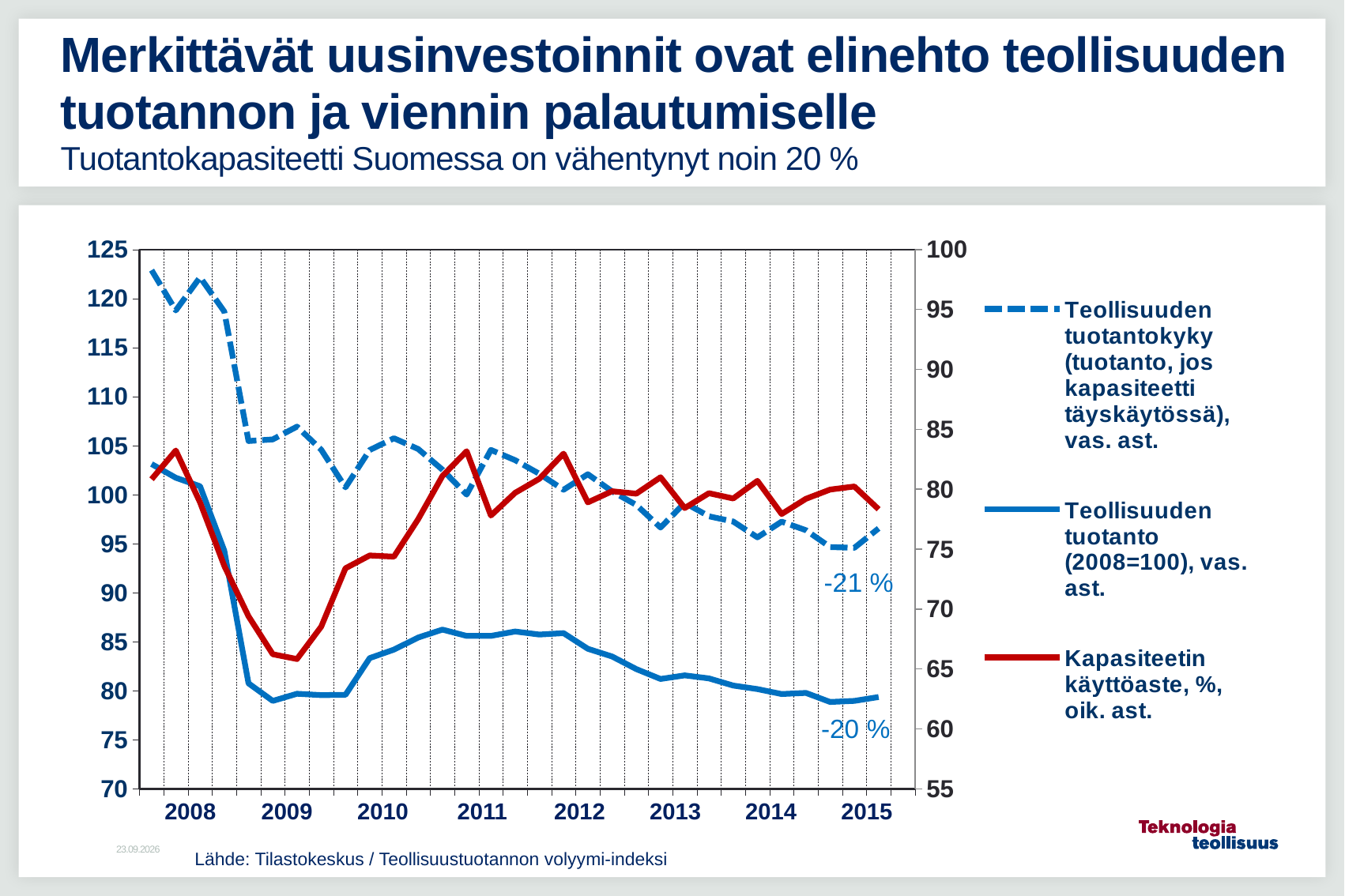
Is the value for Teollisuuden tuotanto in 2015 greater or less than 85 on the left axis? less Is the lowest value of Kapasiteetin käyttöaste in 2009 greater or less than 70 on the right axis? less What percentage change is annotated on the chart for Teollisuuden tuotantokyky? -21 % How many series does the legend list? 3 Is the value for Teollisuuden tuotantokyky at the start of 2008 greater or less than 120 on the left axis? greater What kind of chart is shown on the slide? line chart Does Teollisuuden tuotanto rise or fall overall from 2008 to 2015? fall Which series is drawn with a dashed line? Teollisuuden tuotantokyky Does Teollisuuden tuotantokyky rise or fall overall from 2008 to 2015? fall What percentage change is annotated on the chart for Teollisuuden tuotanto? -20 % Which series is plotted against the right-hand axis (oik. ast.)? Kapasiteetin käyttöaste, % In 2015, which is higher on the left axis: Teollisuuden tuotantokyky or Teollisuuden tuotanto? Teollisuuden tuotantokyky